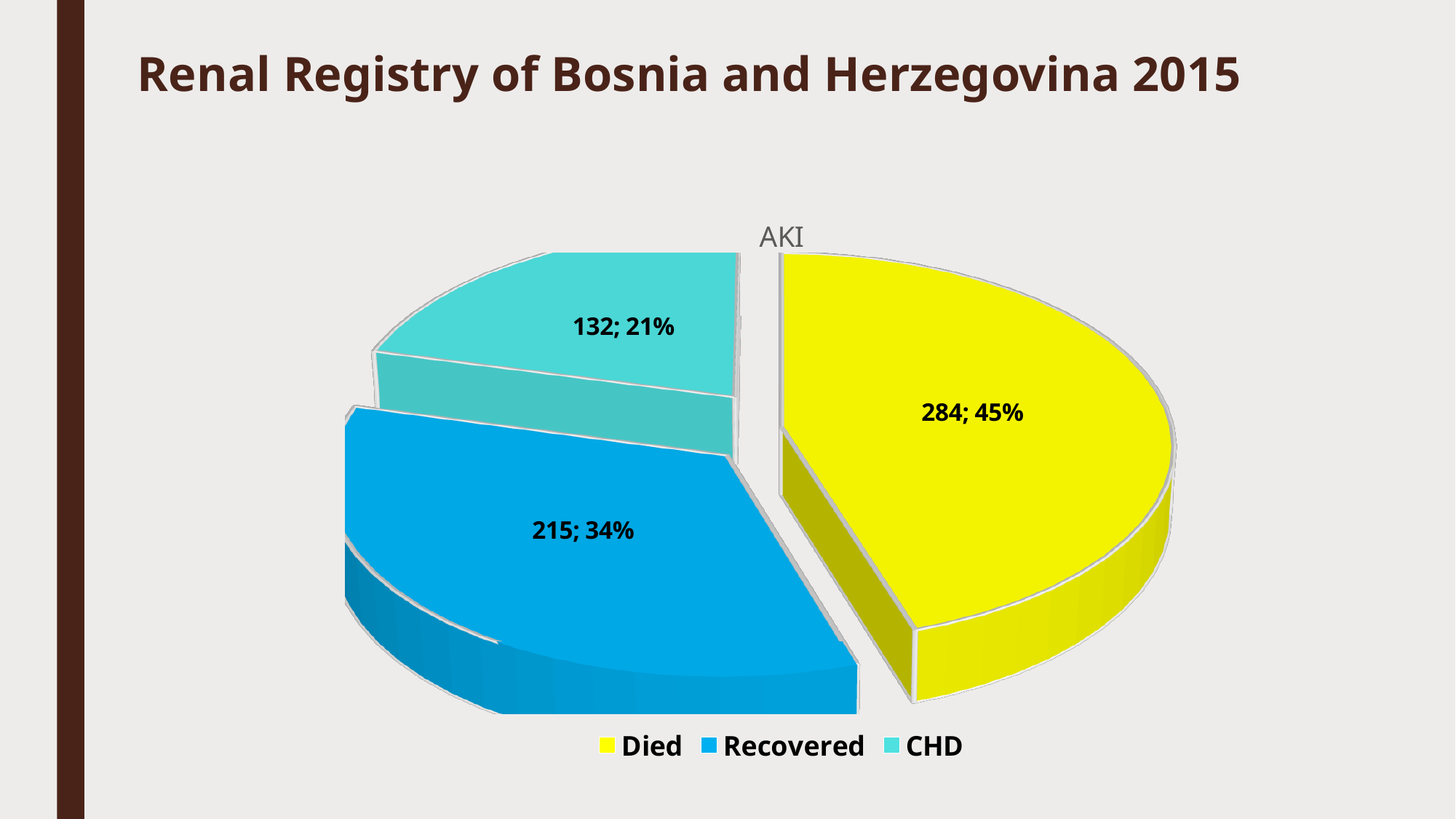
What is the value for Died? 284 What is the title of the chart? AKI What is the difference between the values for Died and Recovered? 69 How many slices does the pie chart have? 3 What is the value for Recovered? 215 What share of the pie does the Died slice represent? 45% Which category has the smallest slice? CHD What type of chart is shown on the slide? pie chart How many entries does the legend list? 3 Which category has the largest slice? Died What is the value for CHD? 132 What share of the pie does the CHD slice represent? 21%